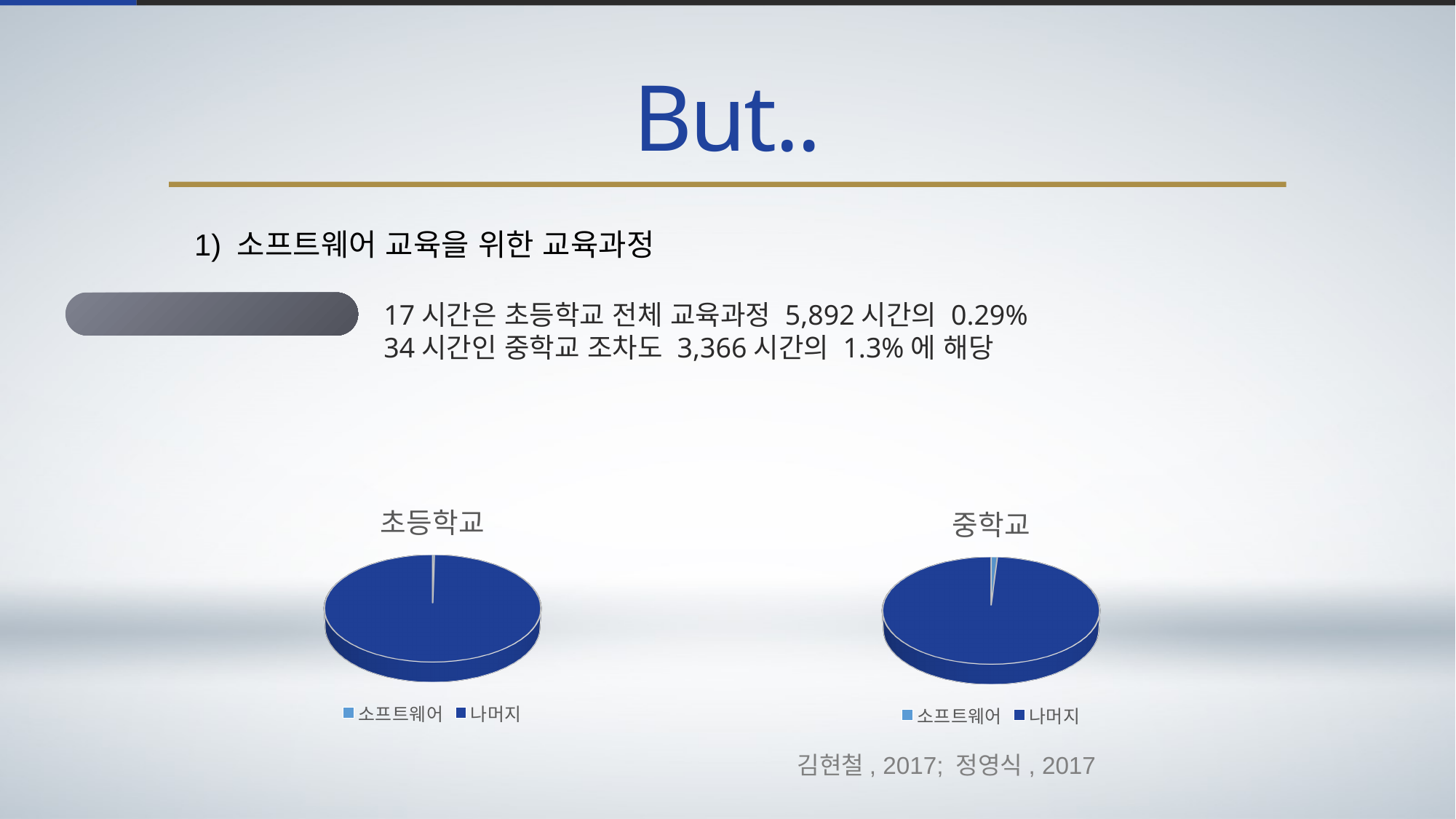
What is the title of the pie chart on the right? 중학교 What kind of chart is the 초등학교 chart? pie chart In the 중학교 chart, which slice is the smallest? 소프트웨어 In the 초등학교 chart, which slice is the smallest? 소프트웨어 How many slices does the 초등학교 pie chart have? 2 How many pie charts are shown on the slide? 2 How many entries does the legend of the 중학교 chart list? 2 In the 초등학교 chart, which slice is the largest? 나머지 In the 중학교 chart, which slice is the largest? 나머지 What are the legend entries of the 초등학교 chart? 소프트웨어, 나머지 What kind of chart is the 중학교 chart? pie chart In the 중학교 chart, which is larger, 소프트웨어 or 나머지? 나머지